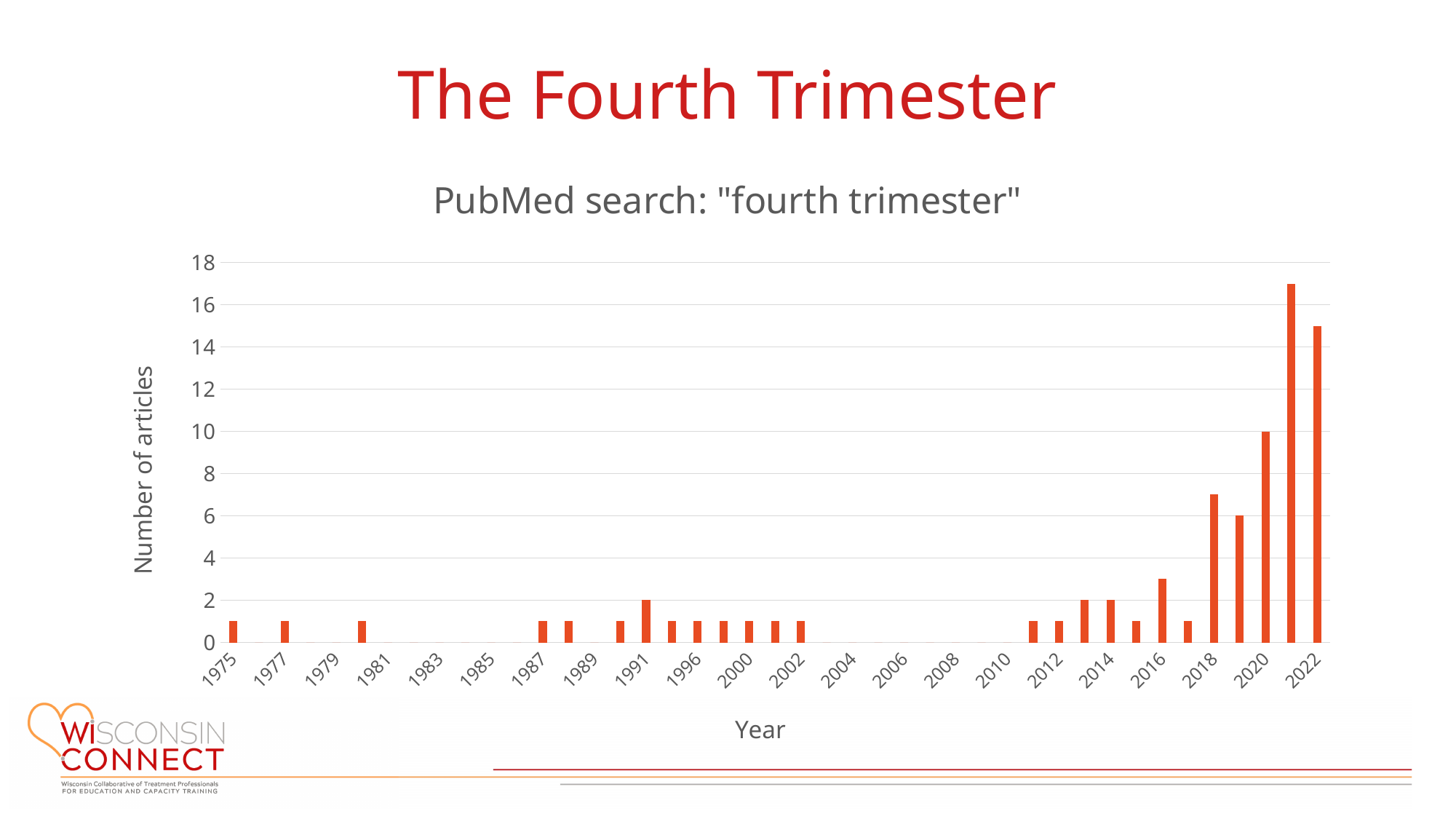
How many articles are shown for 2020? 10 Is the value for 2018 greater or less than 8? less Which year has more articles, 2020 or 2022? 2022 How many articles are shown for 2014? 2 What kind of chart is shown on the slide? bar chart Do the number of articles generally rise or fall from 2012 to 2022? rise Is the value for 2016 greater or less than 4? less How many articles are shown for 1991? 2 What is the label of the vertical axis? Number of articles Is the value for 2022 greater or less than 14? greater What is the title of the chart? PubMed search: "fourth trimester" What is the difference between the number of articles in 2020 and in 2014? 8